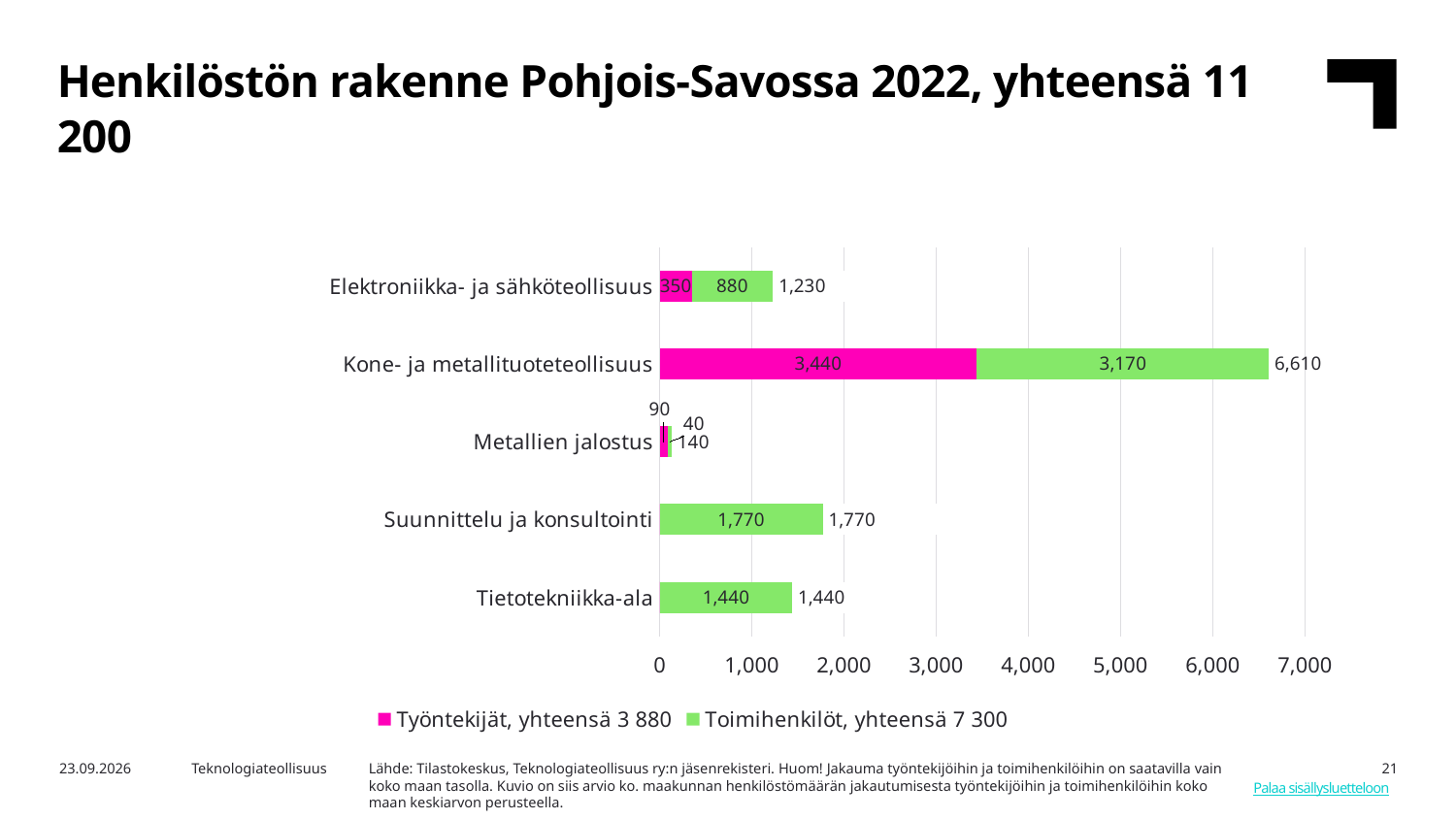
What is the Työntekijät value for Kone- ja metallituoteteollisuus? 3,440 What is the total of the stacked bar for Metallien jalostus? 140 What is the total of the stacked bar for Kone- ja metallituoteteollisuus? 6,610 What is the difference between the Työntekijät and Toimihenkilöt values for Kone- ja metallituoteteollisuus? 270 How many categories are shown on the chart? 5 What type of chart is shown on the slide? Stacked bar chart Which category has the lowest total? Metallien jalostus Which category has the highest total? Kone- ja metallituoteteollisuus What is the Toimihenkilöt value for Elektroniikka- ja sähköteollisuus? 880 What total is given in the legend for Toimihenkilöt? 7 300 How many series does the legend list? 2 Which is larger: the total for Suunnittelu ja konsultointi or the total for Tietotekniikka-ala? Suunnittelu ja konsultointi